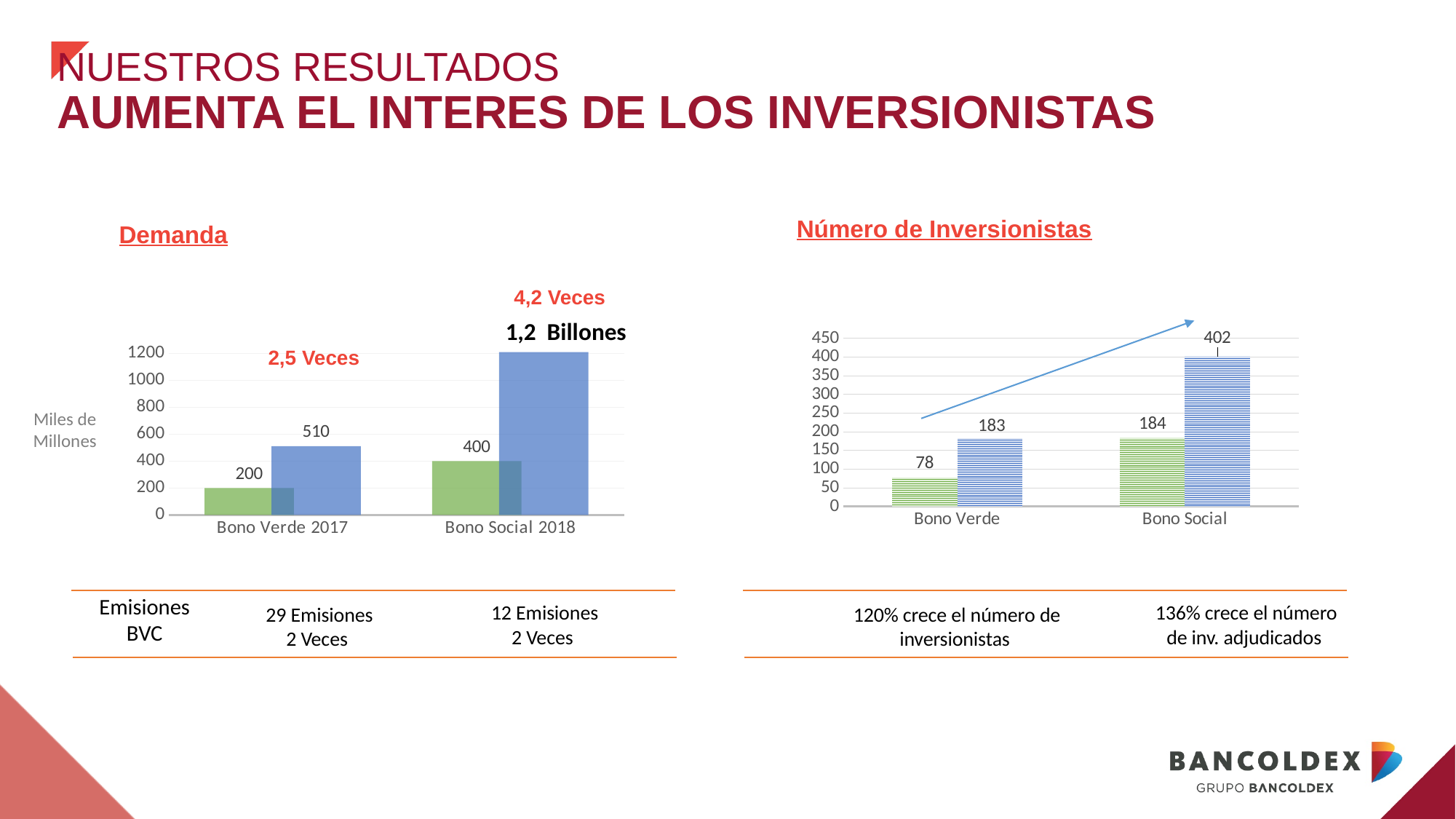
In the Número de Inversionistas chart, which is larger: the green bar for Bono Social or the blue bar for Bono Verde? Green bar for Bono Social (184) In the Demanda chart, what is the value of the green bar for Bono Verde 2017? 200 In the Demanda chart, what is the value of the green bar for Bono Social 2018? 400 In the Número de Inversionistas chart, what is the value of the blue bar for Bono Social? 402 In the Número de Inversionistas chart, which bar has the highest value? Bono Social (blue bar), 402 In the Demanda chart, what is the value of the blue bar for Bono Verde 2017? 510 In the Demanda chart, what unit is shown on the vertical axis label? Miles de Millones In the Demanda chart, is the blue bar for Bono Social 2018 greater or less than 1000? greater In the Número de Inversionistas chart, what is the value of the green bar for Bono Verde? 78 In the Número de Inversionistas chart, what is the difference between the blue bars for Bono Social and Bono Verde? 219 In the Demanda chart, what is the difference between the blue and green bars for Bono Verde 2017? 310 What type of chart is the Número de Inversionistas chart? Bar chart